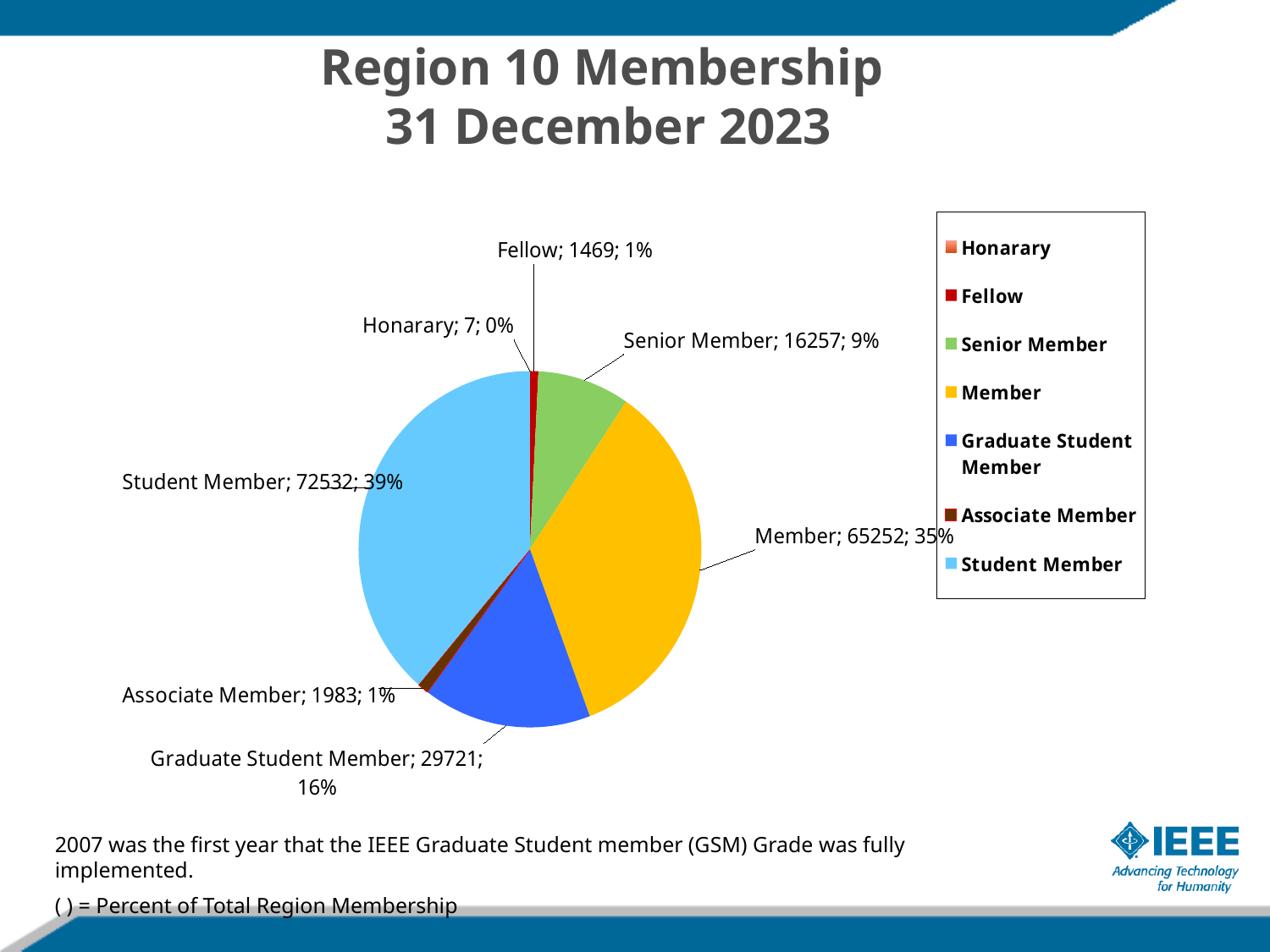
How many membership grades are shown in the pie chart? 7 Which membership grade has the largest slice? Student Member Which membership grade has the smallest slice? Honarary What is the value for Senior Member? 16257 Which is larger, the number of Fellows or the number of Associate Members? Associate Member What share of the pie does Graduate Student Member represent? 16% What percentage of total Region 10 membership is Member? 35% How many entries does the legend list? 7 How many Student Members does the chart show? 72532 What is the title of the chart? Region 10 Membership 31 December 2023 What is the difference between the number of Student Members and Members? 7280 What type of chart is shown on the slide? pie chart